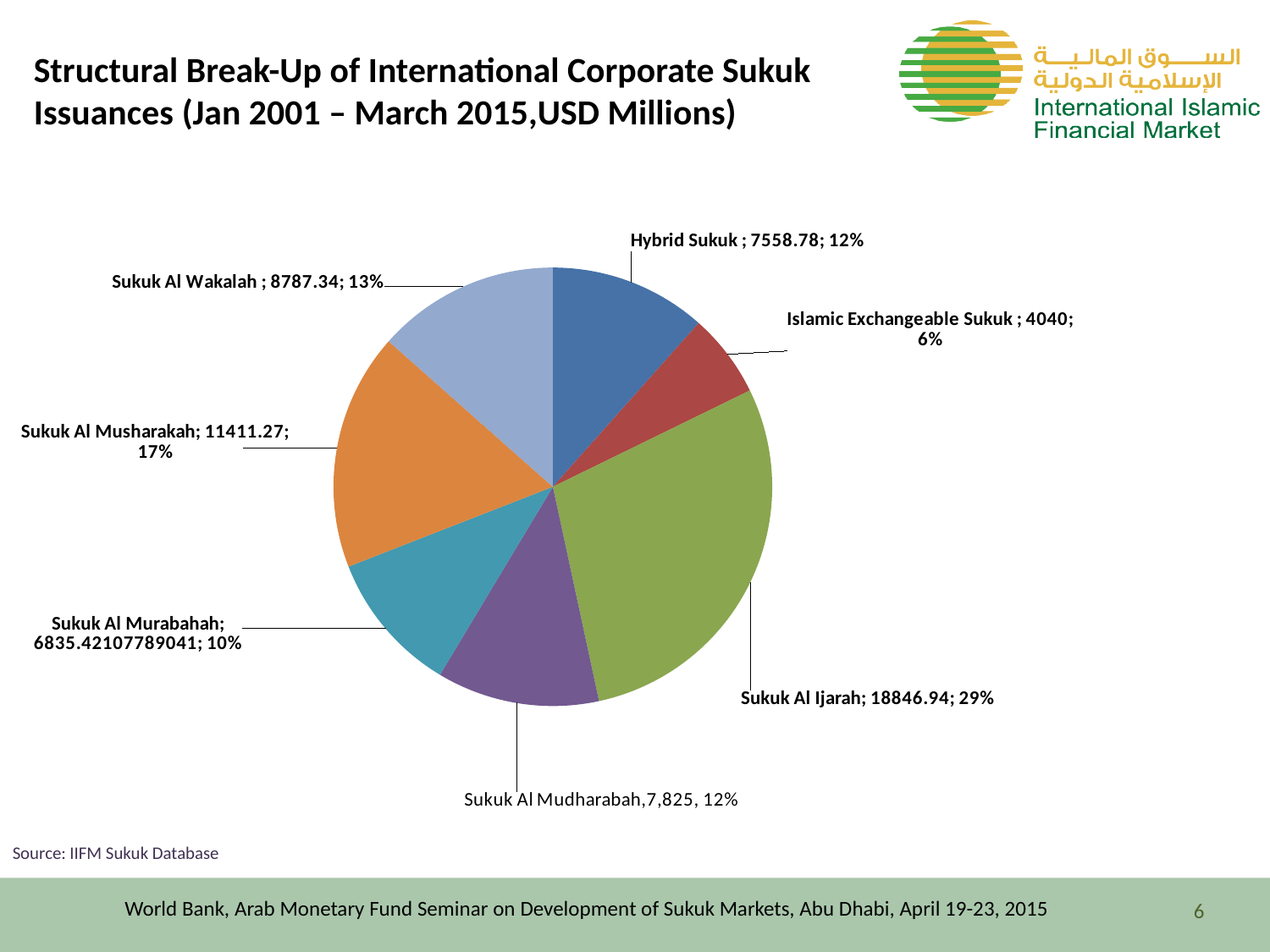
What is the value for Islamic Exchangeable Sukuk? 4040 Which category has the smallest slice of the pie? Islamic Exchangeable Sukuk Which category has the largest slice of the pie? Sukuk Al Ijarah What is the value for Sukuk Al Musharakah? 11411.27 What is the difference between the values for Sukuk Al Ijarah and Sukuk Al Musharakah? 7435.67 What is the title of the chart on the slide? Structural Break-Up of International Corporate Sukuk Issuances (Jan 2001 – March 2015,USD Millions) What is the value for Sukuk Al Ijarah? 18846.94 Which is larger, the value for Sukuk Al Wakalah or the value for Hybrid Sukuk? Sukuk Al Wakalah What type of chart is shown on the slide? Pie chart What share of the pie does Sukuk Al Wakalah represent? 13% What share of the pie does Sukuk Al Murabahah represent? 10% How many slices does the pie chart have? 7